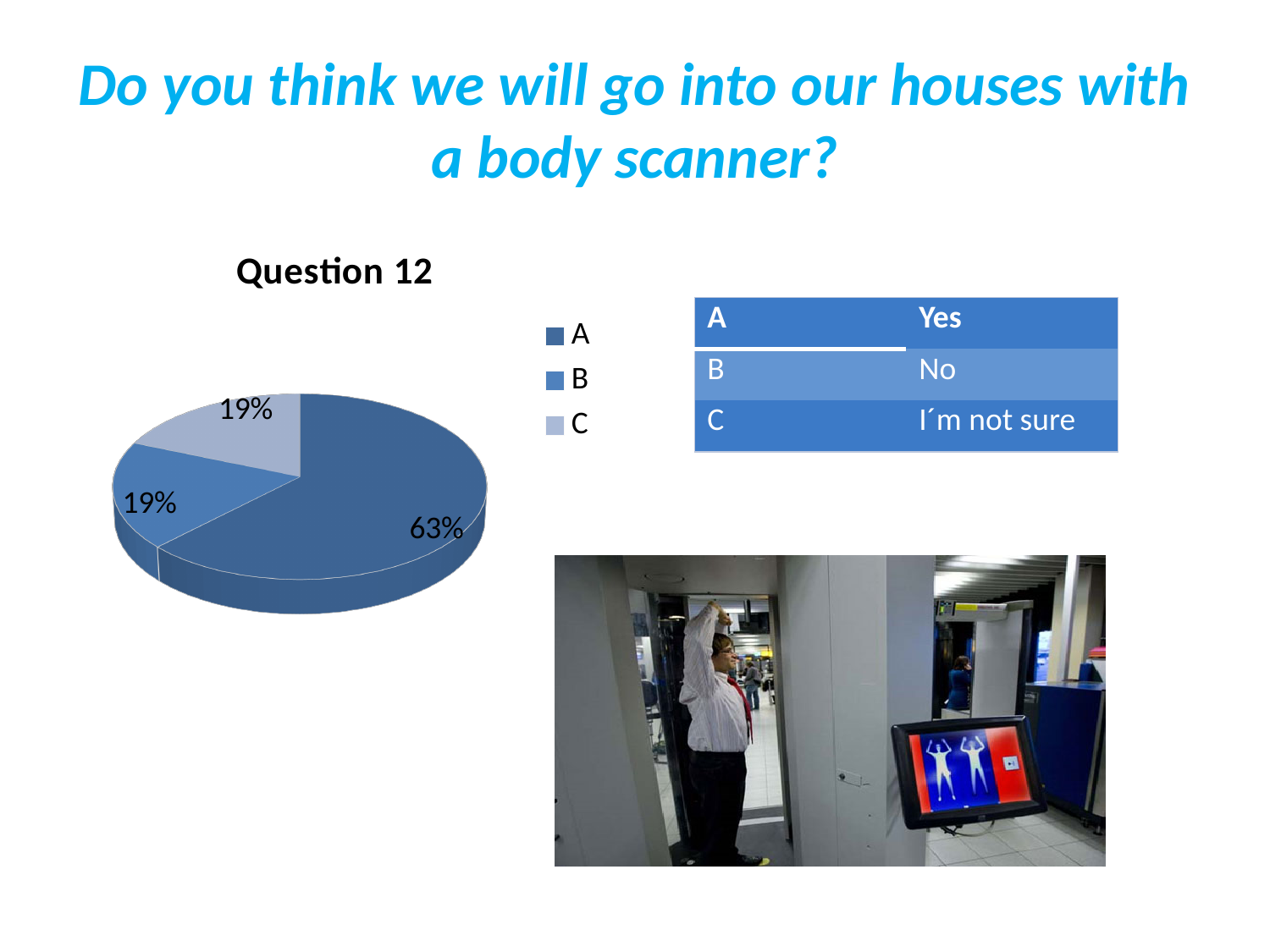
What percentage of the pie does slice B represent? 19% What percentage of the pie does slice C represent? 19% What share of the pie is taken by the slice labelled A? 63% How many slices does the pie chart have? 3 How many entries does the chart legend list? 3 What is the difference in percentage points between slice A and slice C? 44 Which slice is the largest in the pie chart? A What is the title of the chart? Question 12 What kind of chart is shown on the slide? pie chart Which legend entry is shown in the lightest blue colour? C What percentage of the pie does slice A represent? 63% Which is larger, slice A or slice B? A